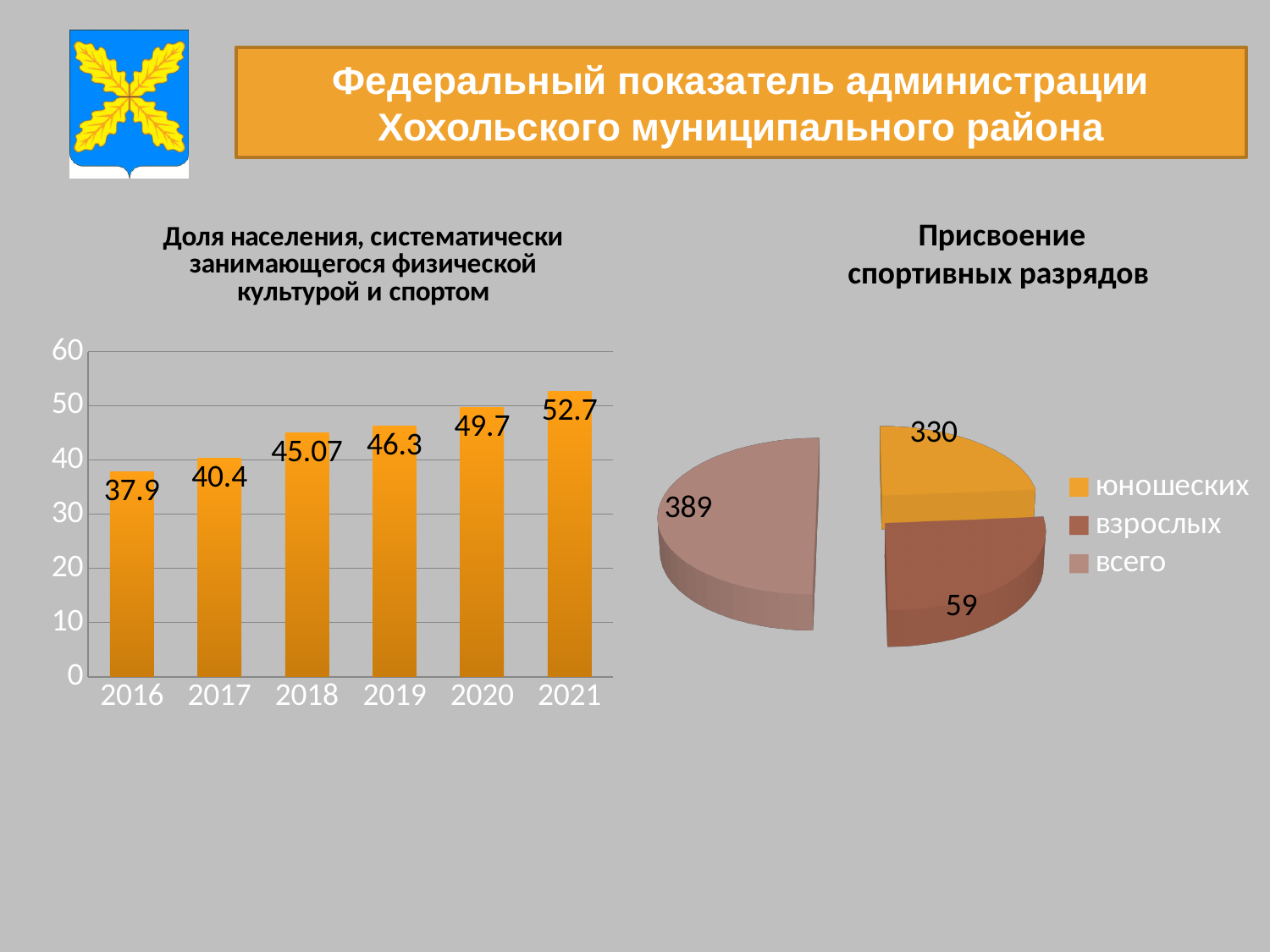
In the bar chart on the left, what is the value for 2021? 52.7 In the bar chart on the left, what is the value for 2018? 45.07 In the bar chart on the left, which year has the highest value? 2021 How many years are shown in the bar chart on the left? 6 How many entries does the legend of the pie chart on the right list? 3 In the bar chart on the left, what is the value for 2016? 37.9 In the bar chart on the left, do the values rise or fall from 2016 to 2021? rise In the bar chart on the left, what is the difference between the values for 2021 and 2016? 14.8 In the bar chart on the left, which year has the lowest value? 2016 What kind of chart is the chart on the left? bar chart In the pie chart on the right, what is the value for взрослых? 59